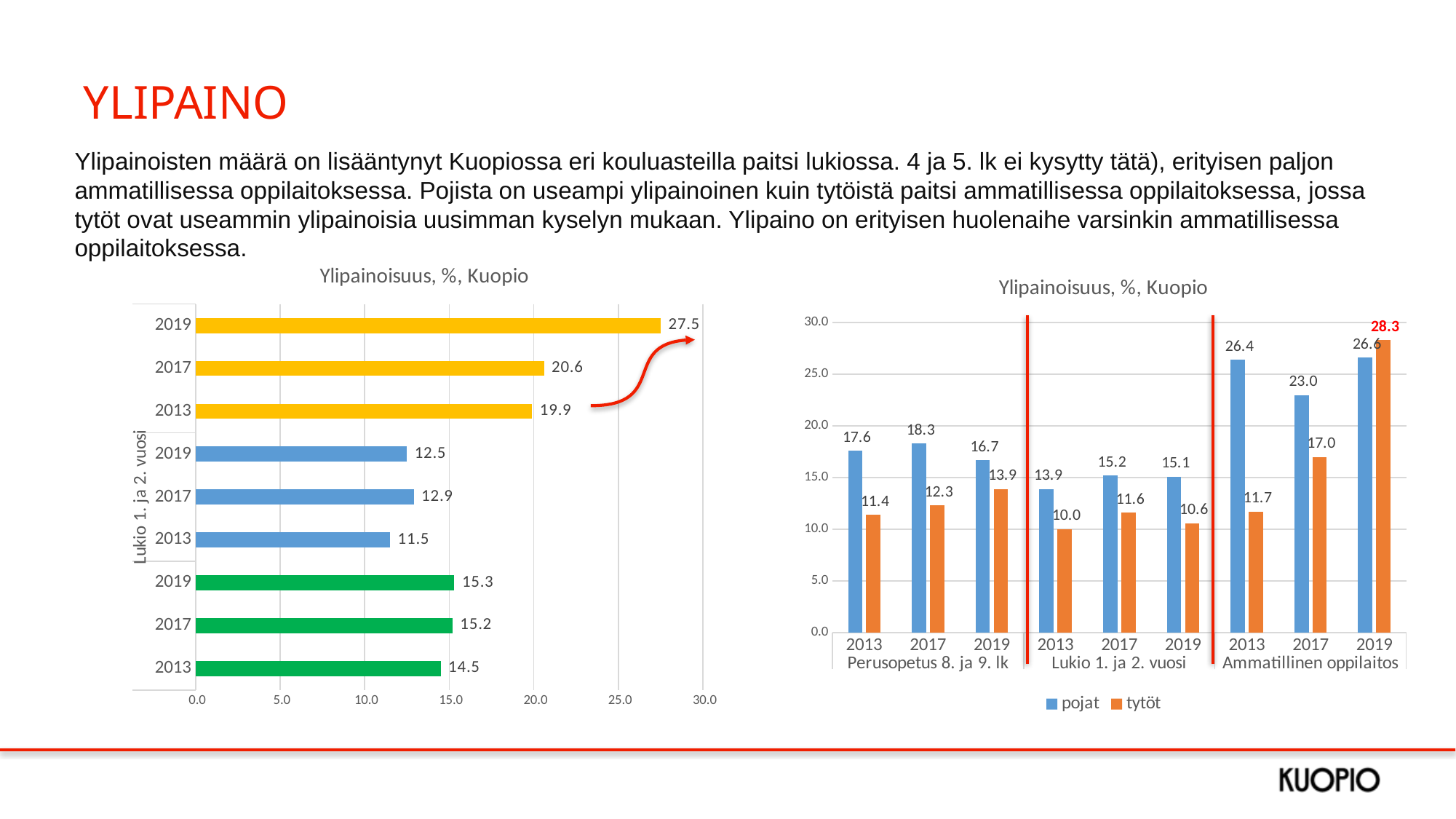
In the left chart, what is the lowest value shown on any bar? 11.5 In the right chart, which is larger in Ammatillinen oppilaitos in 2013: pojat or tytöt? pojat In the right chart, what is the value for pojat in Perusopetus 8. ja 9. lk in 2017? 18.3 In the right chart, does the value for tytöt rise or fall from 2013 to 2019 in Ammatillinen oppilaitos? rise How many series does the legend of the right chart list? 2 In the left chart, what is the highest value shown on any bar? 27.5 In the left chart, what is the value for 2019 in the Lukio 1. ja 2. vuosi group? 12.5 In the right chart, what is the value for tytöt in Ammatillinen oppilaitos in 2019? 28.3 What is the title of the right chart? Ylipainoisuus, %, Kuopio What kind of chart is the left chart? bar chart In the right chart, what is the difference between pojat and tytöt in Lukio 1. ja 2. vuosi in 2019? 4.5 In the left chart, what is the difference between the 2019 and 2013 values in the Lukio 1. ja 2. vuosi group? 1.0